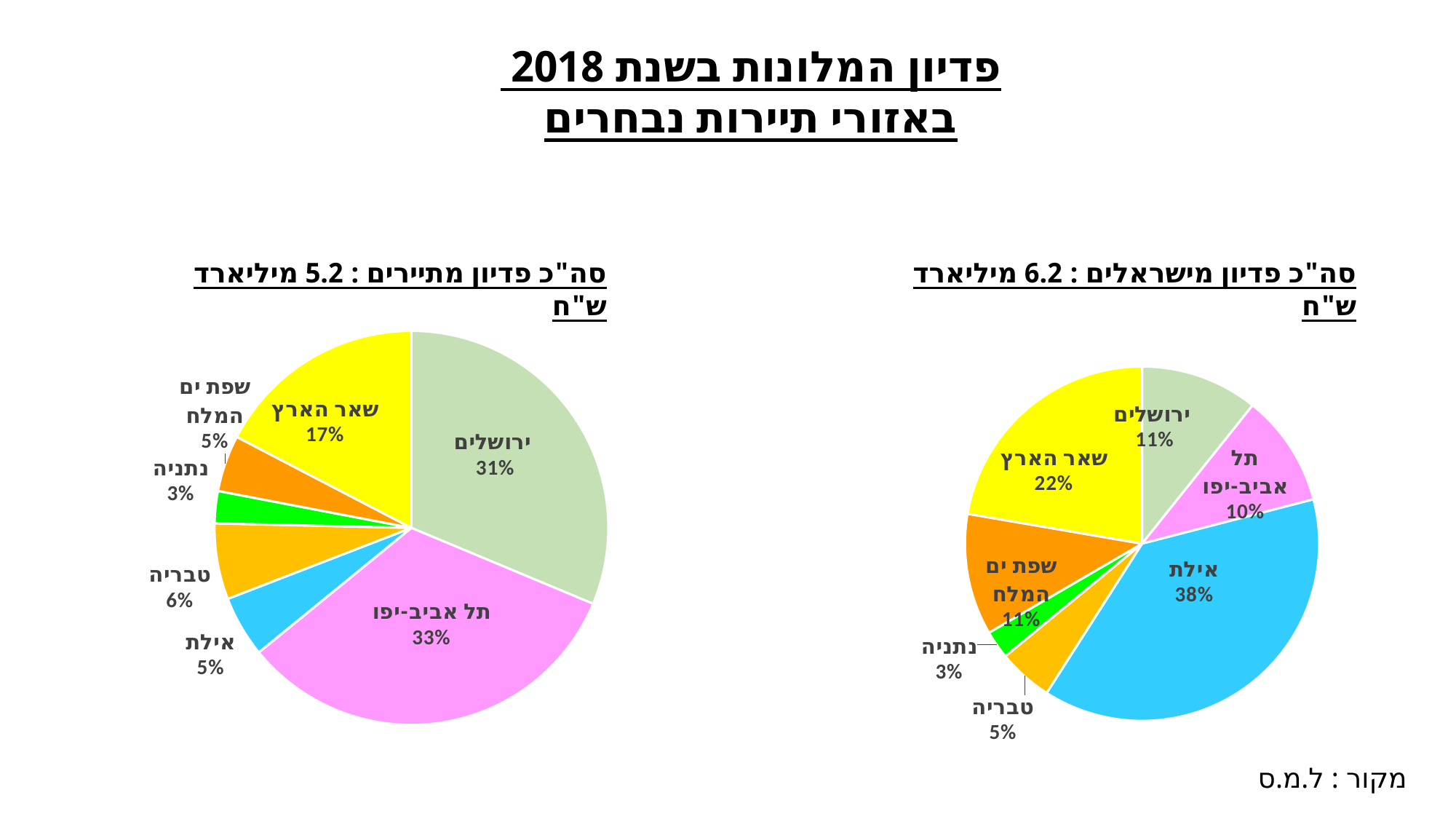
In the right pie chart (Israelis, 6.2 billion NIS), what share does שאר הארץ have? 22% How many slices does the left pie chart (tourists, 5.2 billion NIS) have? 7 In the left pie chart (tourists, 5.2 billion NIS), what share does ירושלים have? 31% In the left pie chart (tourists, 5.2 billion NIS), which region has the smallest share? נתניה In the right pie chart (Israelis, 6.2 billion NIS), which region has the largest share? אילת What type of chart is used on the right side of the slide (Israelis, 6.2 billion NIS)? Pie chart In the left pie chart (tourists, 5.2 billion NIS), what share does תל אביב-יפו have? 33% In the right pie chart (Israelis, 6.2 billion NIS), which is larger: the share of ירושלים or the share of תל אביב-יפו? ירושלים In the right pie chart (Israelis, 6.2 billion NIS), what is the difference in percentage points between אילת and שפת ים המלח? 27 What total revenue is stated in the title of the left pie chart? 5.2 מיליארד ש"ח In the left pie chart (tourists, 5.2 billion NIS), what is the difference in percentage points between תל אביב-יפו and שאר הארץ? 16